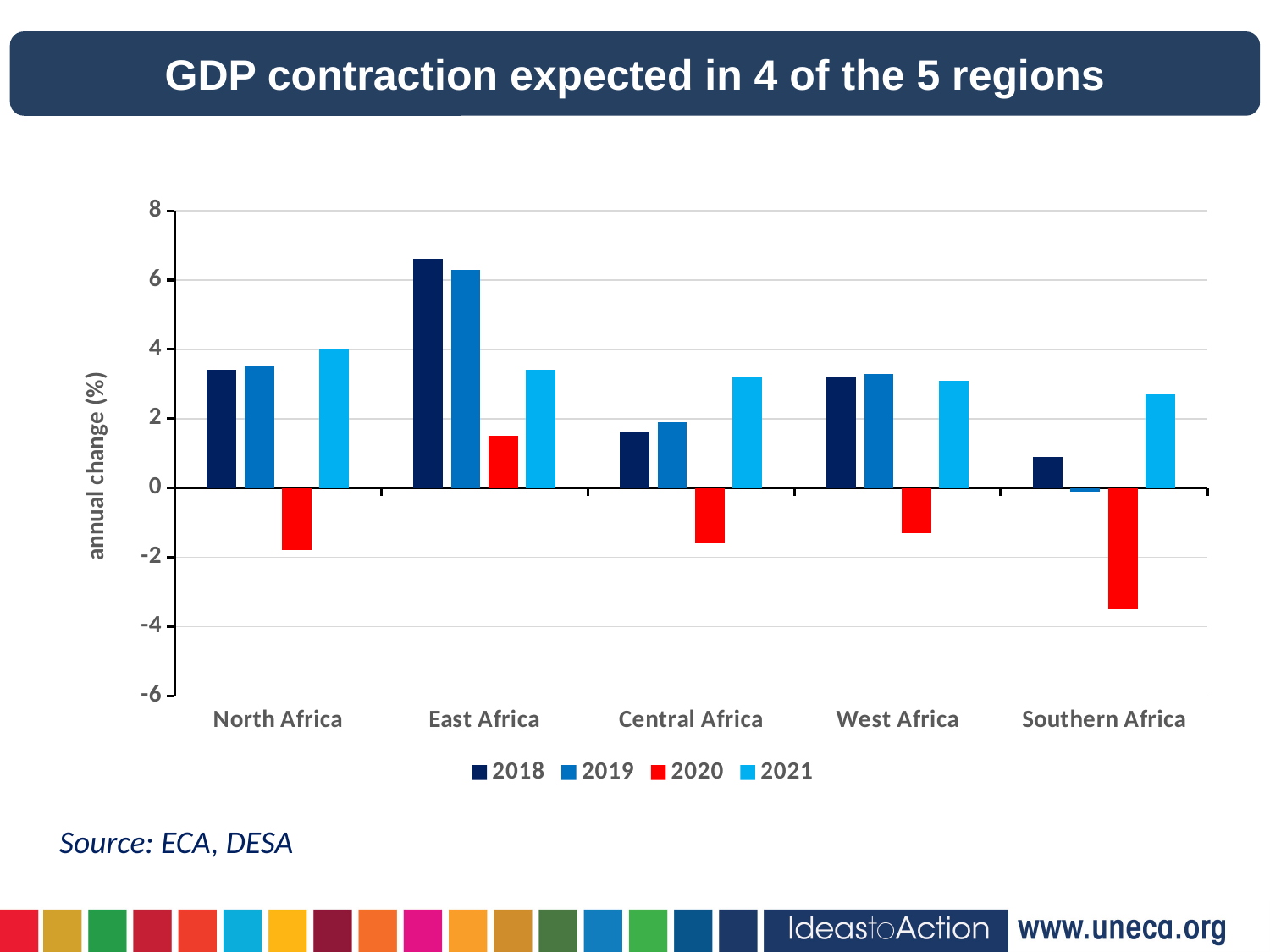
Which region has the highest value for 2018? East Africa How many regions are shown on the x axis? 5 For Central Africa, which is larger, the 2018 value or the 2021 value? 2021 What colour represents the 2020 series in the legend? red Is the 2020 value for Southern Africa greater or less than -2? less Is the 2018 value for East Africa greater or less than 6? greater What kind of chart is shown on the slide? bar chart Which is larger, the 2018 value for East Africa or the 2018 value for North Africa? East Africa Which region has the highest value for 2021? North Africa Is the 2021 value for North Africa greater or less than 2? greater Which region has the lowest value for 2020? Southern Africa How many series does the legend list? 4